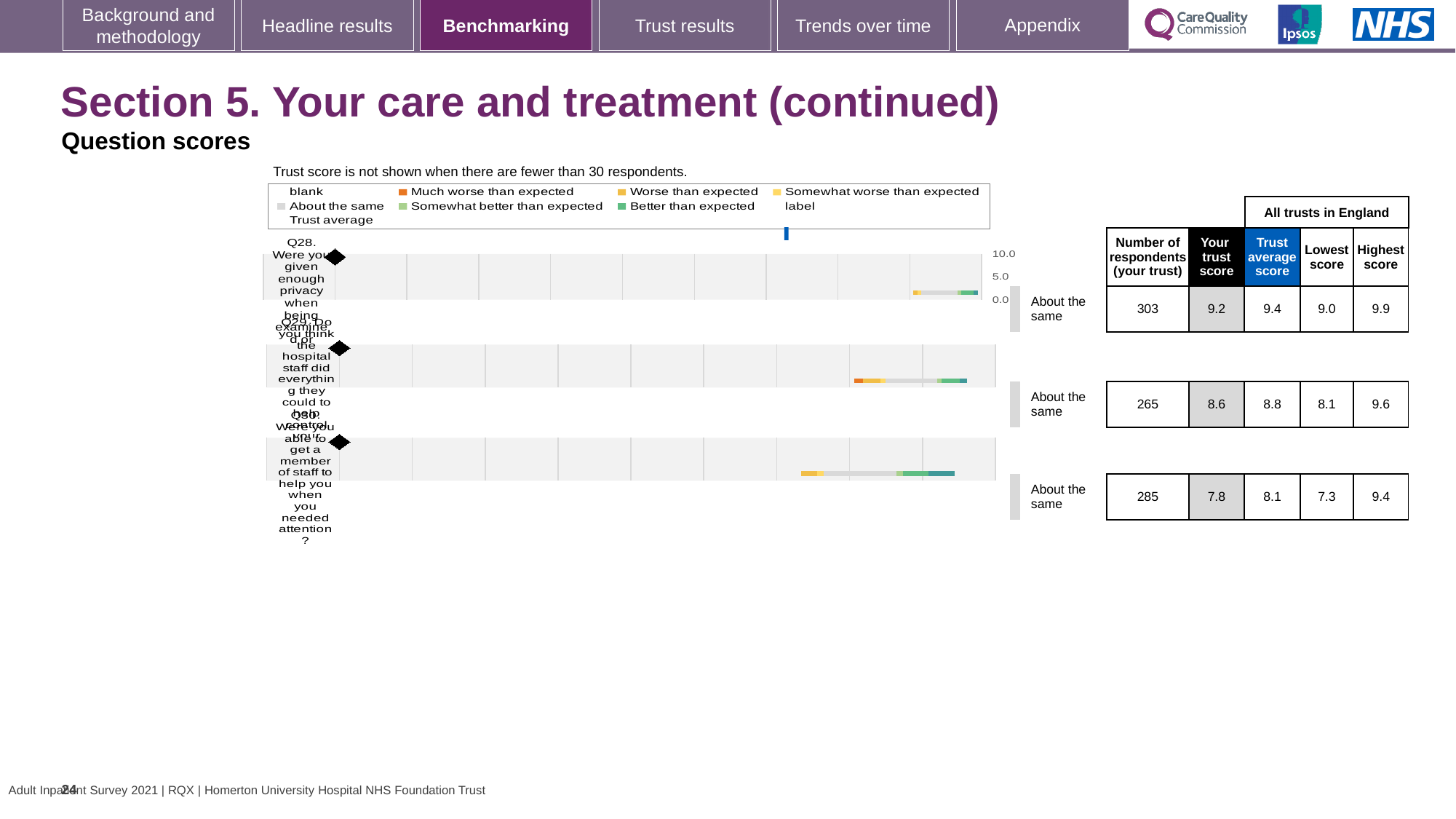
Which question has the lowest trust score on this slide? Q30 What is the difference between the highest score and the lowest score for Q30? 2.1 What is the maximum value shown on the chart's score axis? 10.0 What kind of chart is used to show the question scores? Bar chart What is the highest score across all trusts in England for Q30 (Were you able to get a member of staff to help you when you needed attention?)? 9.4 Which question has the highest trust score on this slide? Q28 How many respondents answered Q29 (Do you think the hospital staff did everything they could to help control your pain?)? 265 What is the trust score for Q28 (Were you given enough privacy when being examined or treated?)? 9.2 What benchmark category is shown next to the chart for Q30? About the same How many questions are charted on this slide? 3 What is the difference between the trust average score and the trust score for Q28? 0.2 Which has the larger trust score, Q29 or Q30? Q29